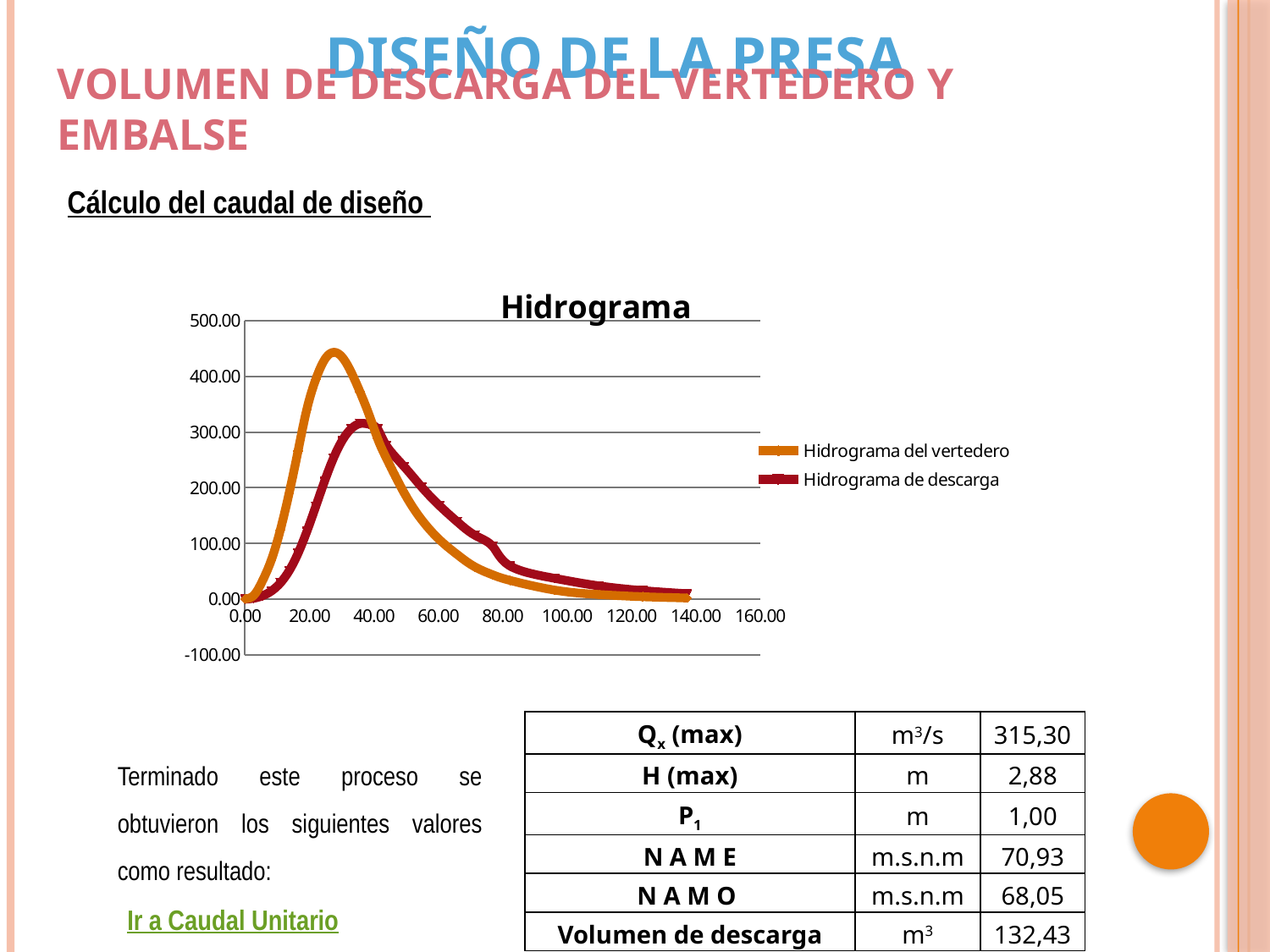
In the 'Hidrograma' chart, is the peak value of 'Hidrograma de descarga' greater or less than 400.00? less How many series does the legend of the 'Hidrograma' chart list? 2 In the 'Hidrograma' chart, which series has the higher value at x = 60.00, 'Hidrograma del vertedero' or 'Hidrograma de descarga'? Hidrograma de descarga In the 'Hidrograma' chart, is the peak value of 'Hidrograma del vertedero' greater or less than 400.00? greater What is the title of the chart on the slide? Hidrograma Which series in the 'Hidrograma' chart is drawn in orange? Hidrograma del vertedero What kind of chart is the 'Hidrograma' chart? line chart In the 'Hidrograma' chart, is the value of 'Hidrograma de descarga' at x = 60.00 greater or less than 100.00? greater In the 'Hidrograma' chart, do the values of 'Hidrograma del vertedero' rise or fall between x = 40.00 and x = 120.00? fall In the 'Hidrograma' chart, which series reaches the higher peak, 'Hidrograma del vertedero' or 'Hidrograma de descarga'? Hidrograma del vertedero